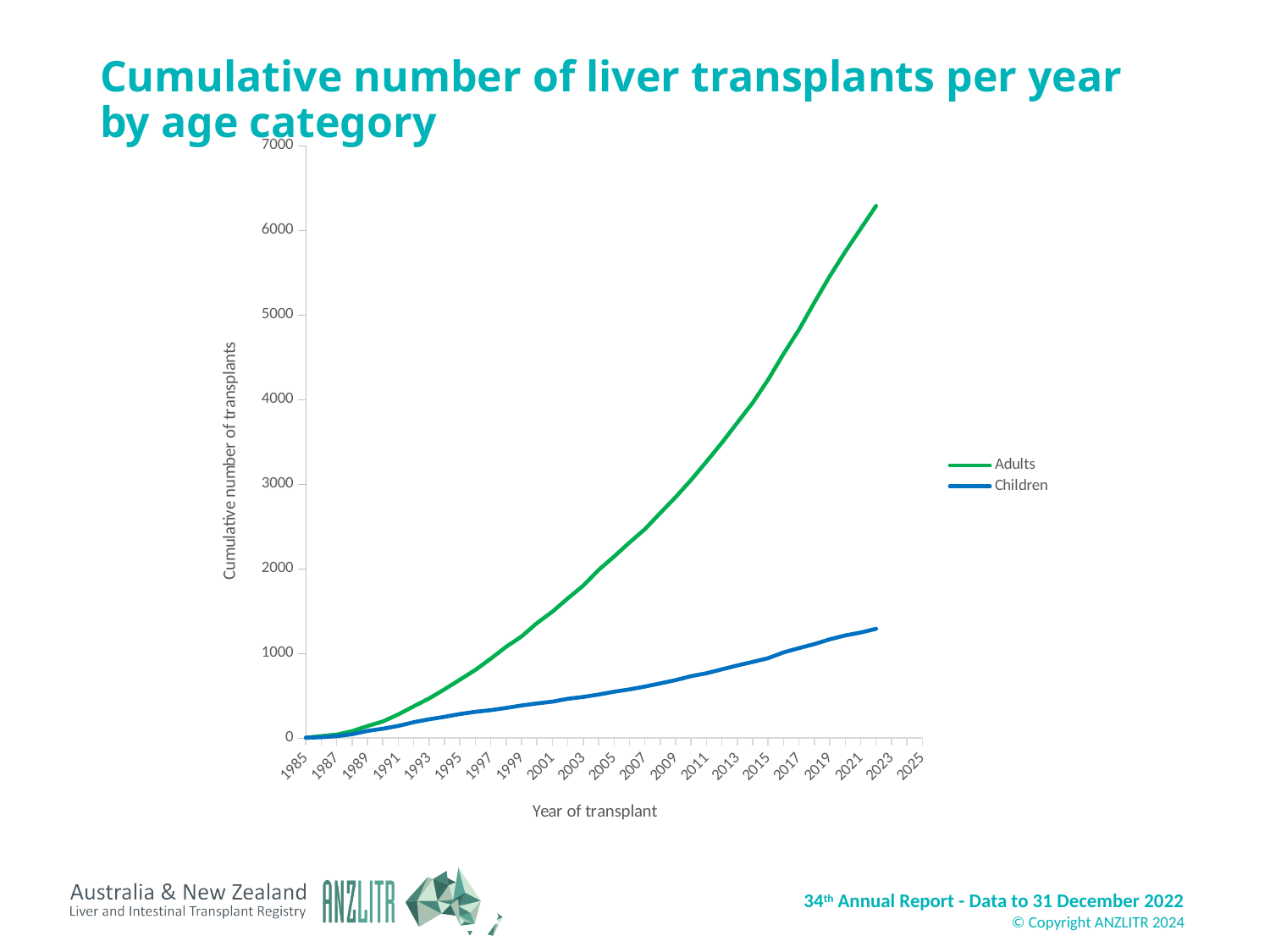
Do the values for Children rise or fall along the x axis? rise What kind of chart is shown on the slide? line chart Is the value for Adults in 2013 greater or less than 3000? greater How many series does the legend list? 2 What is the label of the y axis? Cumulative number of transplants Which series has the higher value in 2021, Adults or Children? Adults Is the value for Adults in 2009 greater or less than 2000? greater Is the final value for Adults (at the right end of the line) greater or less than 6000? greater Which series is shown in green? Adults Do the values for Adults rise or fall from 1985 to 2022? rise